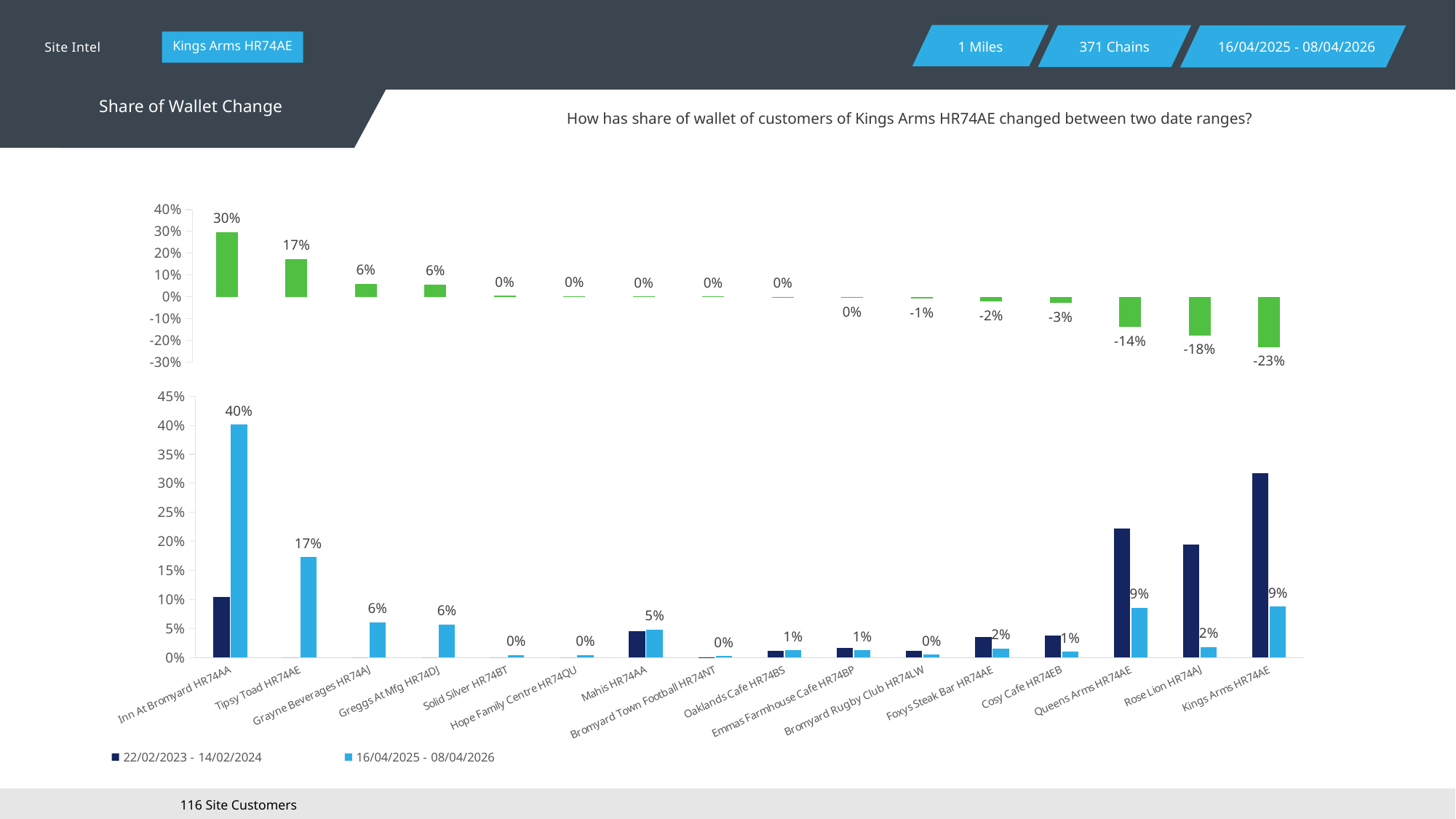
In the bottom chart, what is the value for Mahis HR74AA in the 16/04/2025 - 08/04/2026 series? 5% How many categories are shown on the x axis of the bottom chart? 16 In the top chart, what is the difference between the change for Tipsy Toad HR74AE and the change for Grayne Beverages HR74AJ? 11% In the top chart, which category has the lowest share of wallet change? Kings Arms HR74AE In the top chart, what is the share of wallet change for Inn At Bromyard HR74AA? 30% How many series does the legend of the bottom chart list? 2 In the bottom chart, which is larger for Rose Lion HR74AJ: the 22/02/2023 - 14/02/2024 value or the 16/04/2025 - 08/04/2026 value? 22/02/2023 - 14/02/2024 In the top chart, what is the share of wallet change for Kings Arms HR74AE? -23% In the bottom chart, is the value for Queens Arms HR74AE in the 22/02/2023 - 14/02/2024 series greater or less than 25%? less In the bottom chart, is the value for Kings Arms HR74AE in the 22/02/2023 - 14/02/2024 series greater or less than 30%? greater In the bottom chart, what is the value for Inn At Bromyard HR74AA in the 16/04/2025 - 08/04/2026 series? 40% In the top chart, which category has the highest share of wallet change? Inn At Bromyard HR74AA